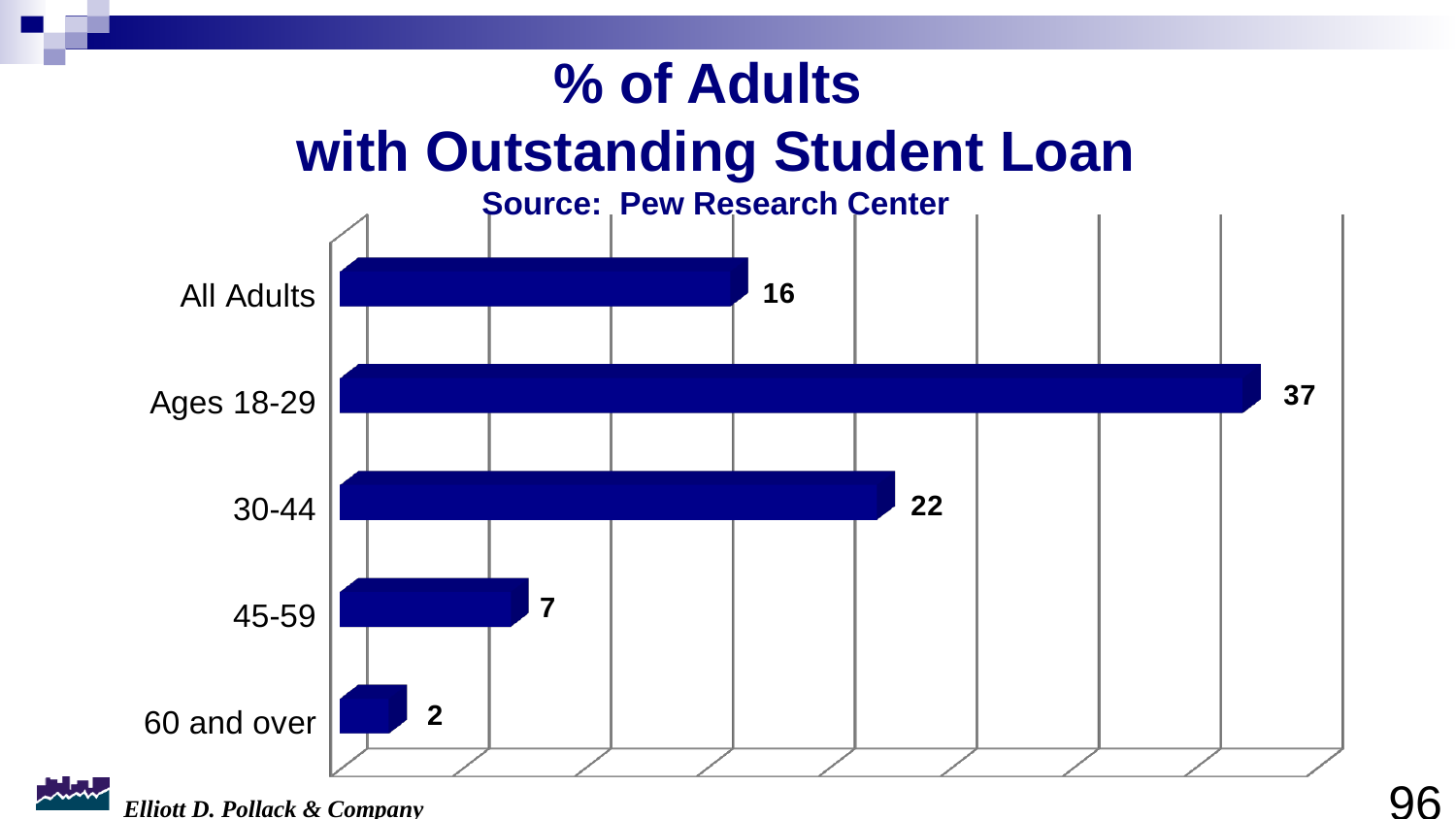
What is the value for All Adults? 16 What is the value for Ages 18-29? 37 Which category has the lowest value? 60 and over What is the value for 60 and over? 2 What kind of chart is shown on the slide? Bar chart What is the value for 30-44? 22 What is the value for 45-59? 7 How many categories are shown in the chart? 5 What source is cited for the chart? Pew Research Center Which category has the highest value? Ages 18-29 Which is larger, the value for All Adults or the value for 45-59? All Adults What is the difference between the values for Ages 18-29 and 30-44? 15